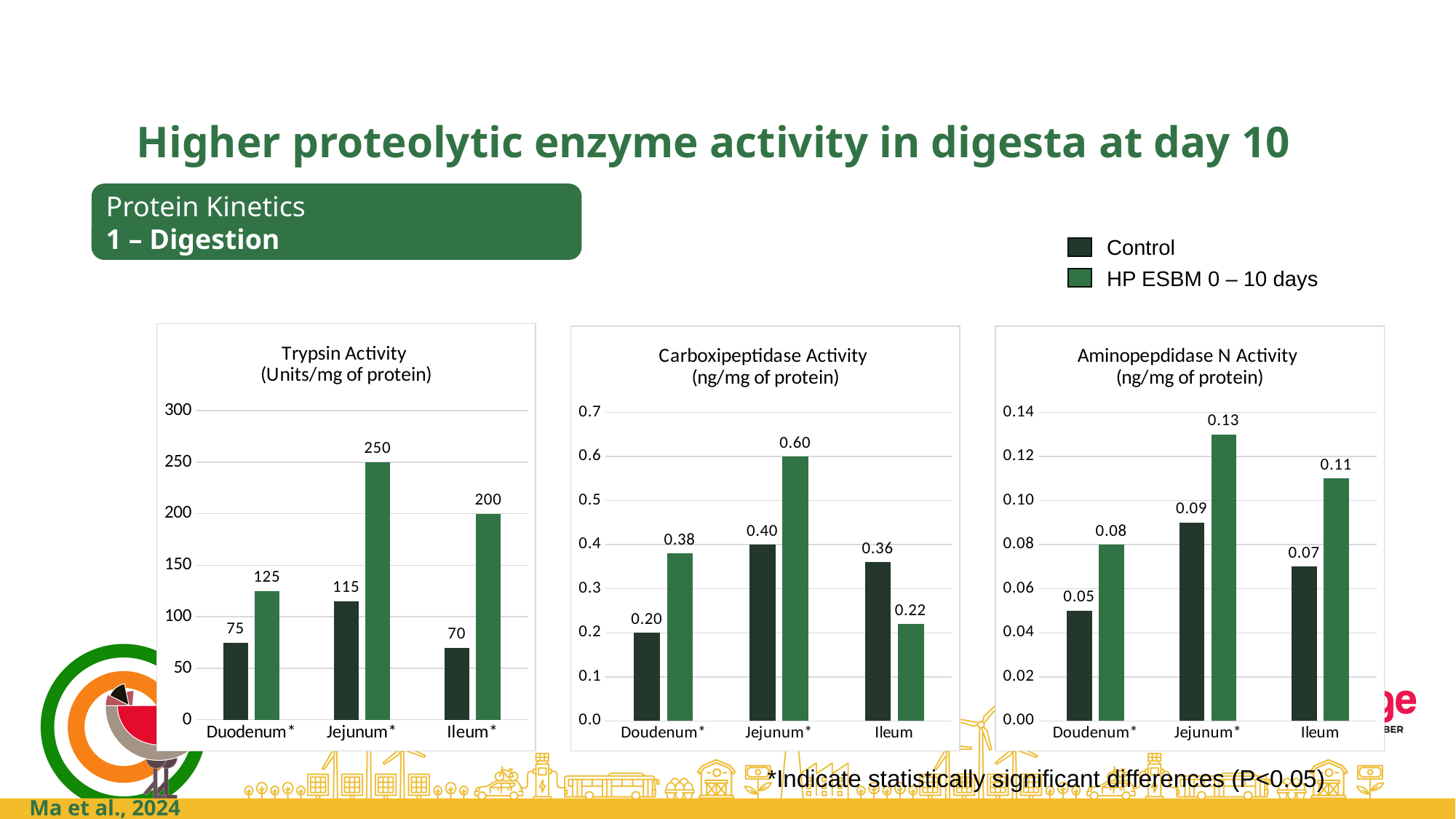
In the Aminopepdidase N Activity chart, what is the Control value for Ileum? 0.07 In the Trypsin Activity chart, what is the HP ESBM 0 – 10 days value for Ileum? 200 In the Aminopepdidase N Activity chart, what is the difference between the HP ESBM 0 – 10 days and Control values for Jejunum? 0.04 In the Trypsin Activity chart, which category has the highest HP ESBM 0 – 10 days value? Jejunum In the Trypsin Activity chart, what is the difference between the HP ESBM 0 – 10 days and Control values for Duodenum? 50 In the Aminopepdidase N Activity chart, how many categories are shown on the x axis? 3 How many series does the legend list for the charts on this slide? 2 In the Carboxipeptidase Activity chart, what is the HP ESBM 0 – 10 days value for Jejunum? 0.60 In the Carboxipeptidase Activity chart, which category has the lowest Control value? Doudenum What kind of chart is the Trypsin Activity chart? Bar chart In the Carboxipeptidase Activity chart, which is larger for Ileum, the Control value or the HP ESBM 0 – 10 days value? Control In the Trypsin Activity chart, what is the Control value for Jejunum? 115